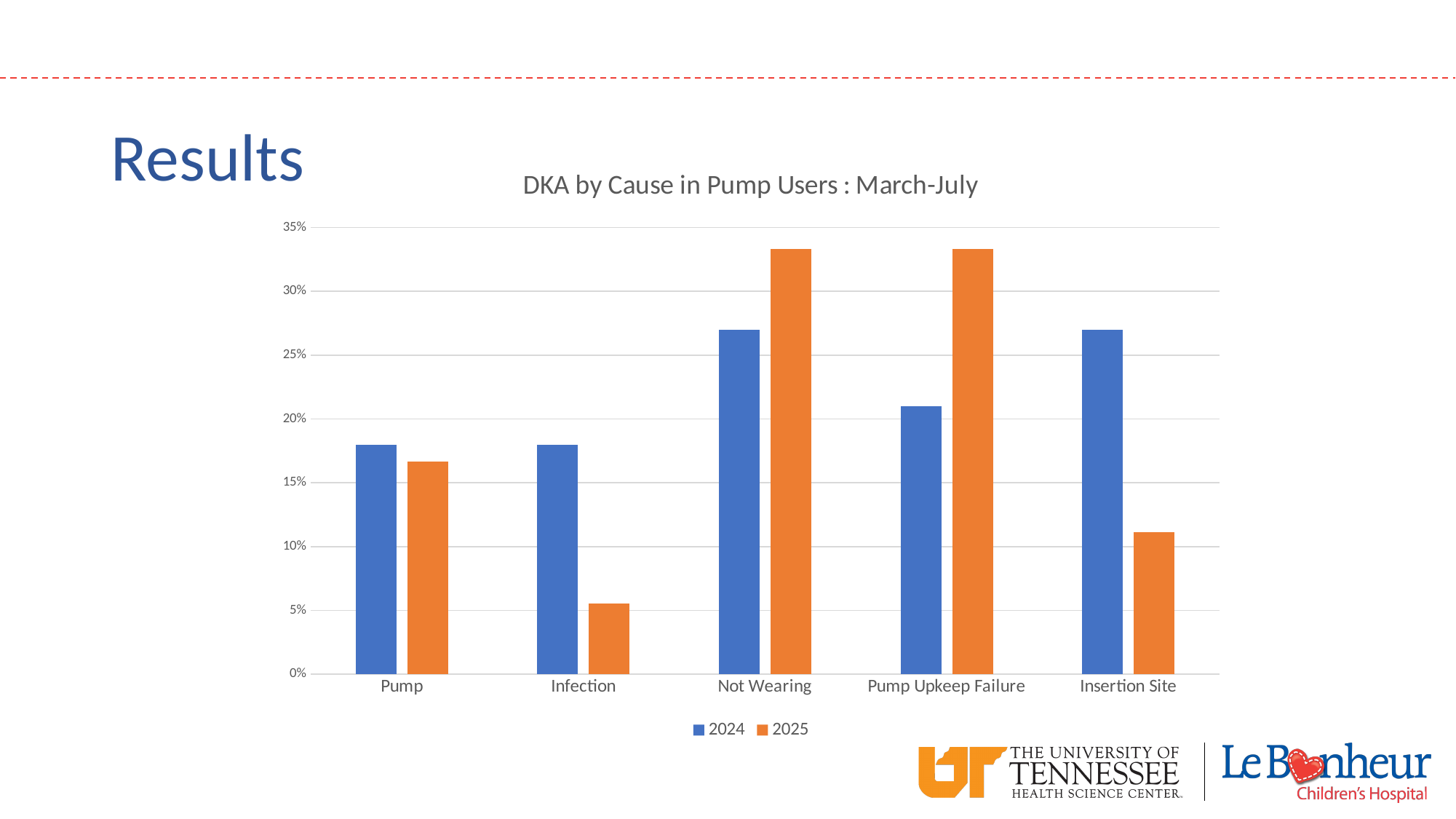
For Infection, which series has the larger value, 2024 or 2025? 2024 Is the 2024 value for Pump Upkeep Failure greater or less than 25%? less Which category has the lowest value for the 2025 series? Infection For Pump Upkeep Failure, which series has the larger value, 2024 or 2025? 2025 What is the title of the chart? DKA by Cause in Pump Users : March-July Is the 2025 value for Not Wearing greater or less than 30%? greater Is the 2025 value for Infection greater or less than 10%? less How many cause categories are shown on the x axis? 5 What type of chart is shown on the slide? Bar chart How many series does the legend list? 2